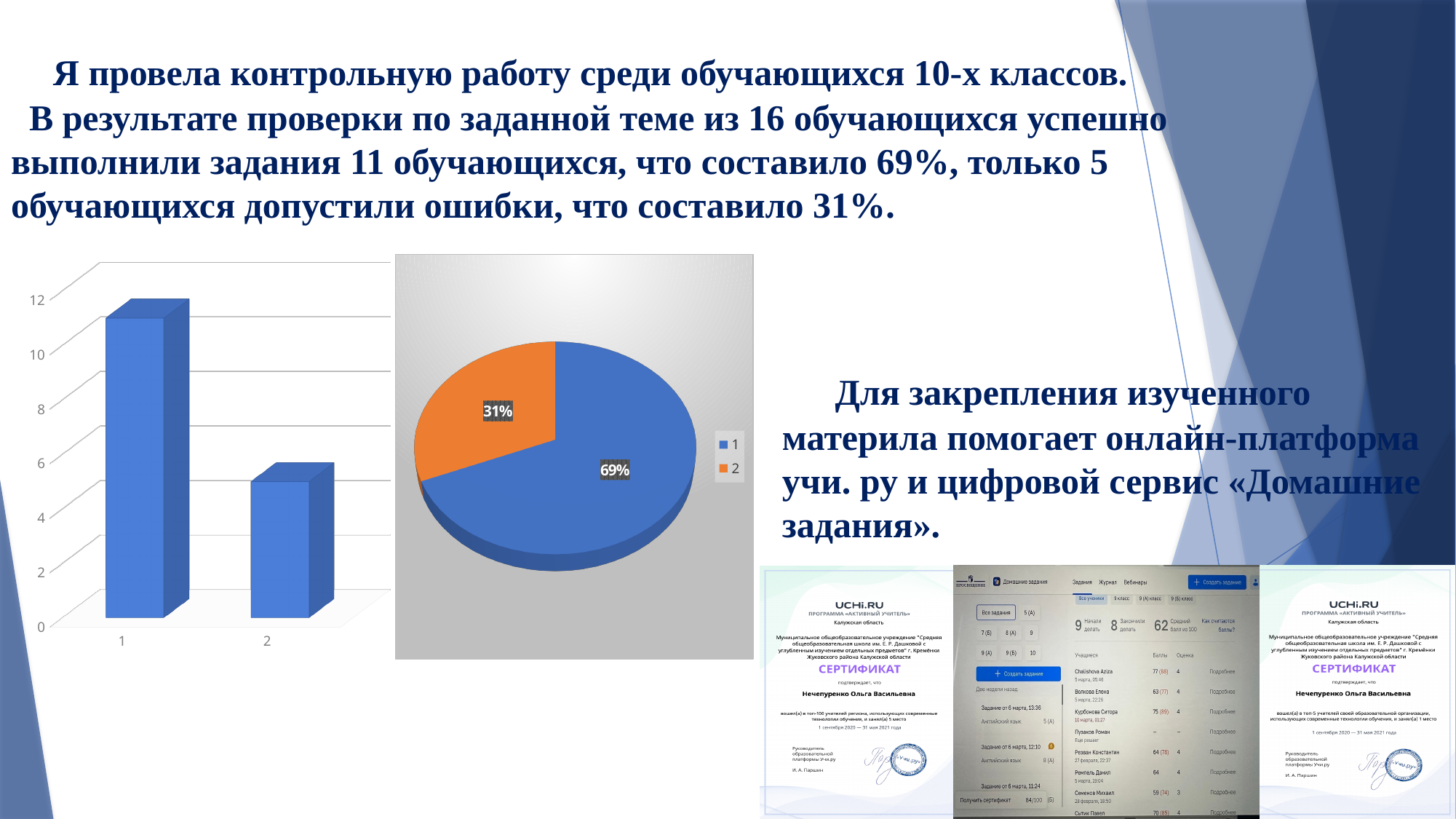
In the pie chart, what percentage is shown for slice 1? 69% In the bar chart on the left, is the value for category 2 greater or less than 8? less In the bar chart on the left, how many categories are shown on the x axis? 2 In the pie chart, what is the difference between the 69% slice and the 31% slice? 38% What kind of chart is the chart on the left of the slide? bar chart In the bar chart on the left, is the value for category 1 greater or less than 10? greater In the pie chart, what percentage is shown for slice 2? 31% How many entries does the legend of the pie chart list? 2 In the bar chart on the left, which category has the shortest bar? 2 In the bar chart on the left, which category has the tallest bar? 1 In the bar chart on the left, do the values rise or fall from category 1 to category 2? fall What kind of chart is the chart in the middle of the slide? pie chart